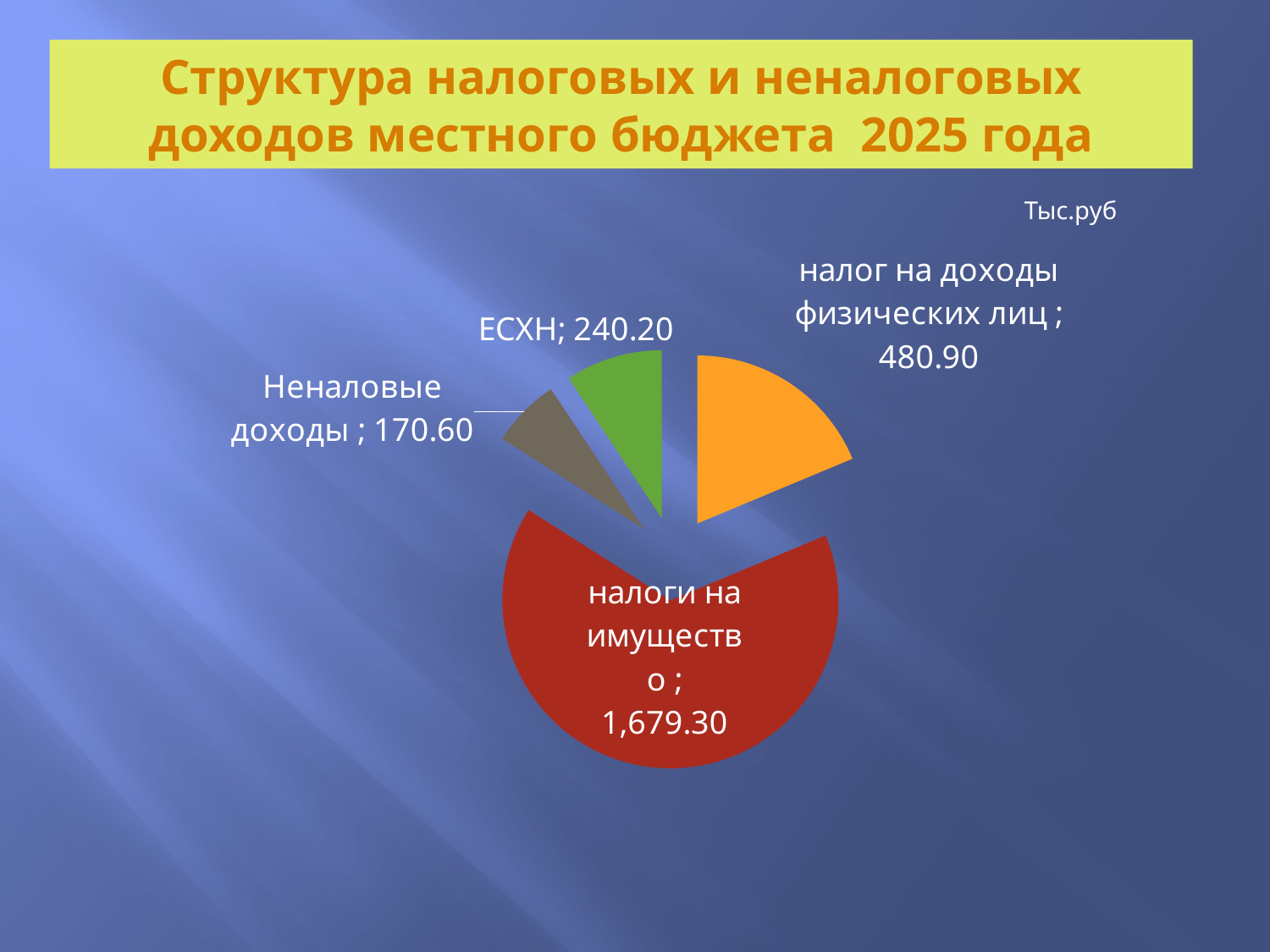
How many categories does the pie chart show? 4 What is the value for Неналовые доходы? 170.60 What is the difference between налоги на имущество and налог на доходы физических лиц? 1,198.40 Which category has the largest slice of the pie? налоги на имущество Which category has the smallest slice of the pie? Неналовые доходы What unit is indicated for the values in the chart? Тыс.руб What type of chart is shown on the slide? pie chart What is the value for ЕСХН? 240.20 What is the value for налоги на имущество? 1,679.30 What is the value for налог на доходы физических лиц? 480.90 What is the difference between ЕСХН and Неналовые доходы? 69.60 Which is larger, ЕСХН or Неналовые доходы? ЕСХН